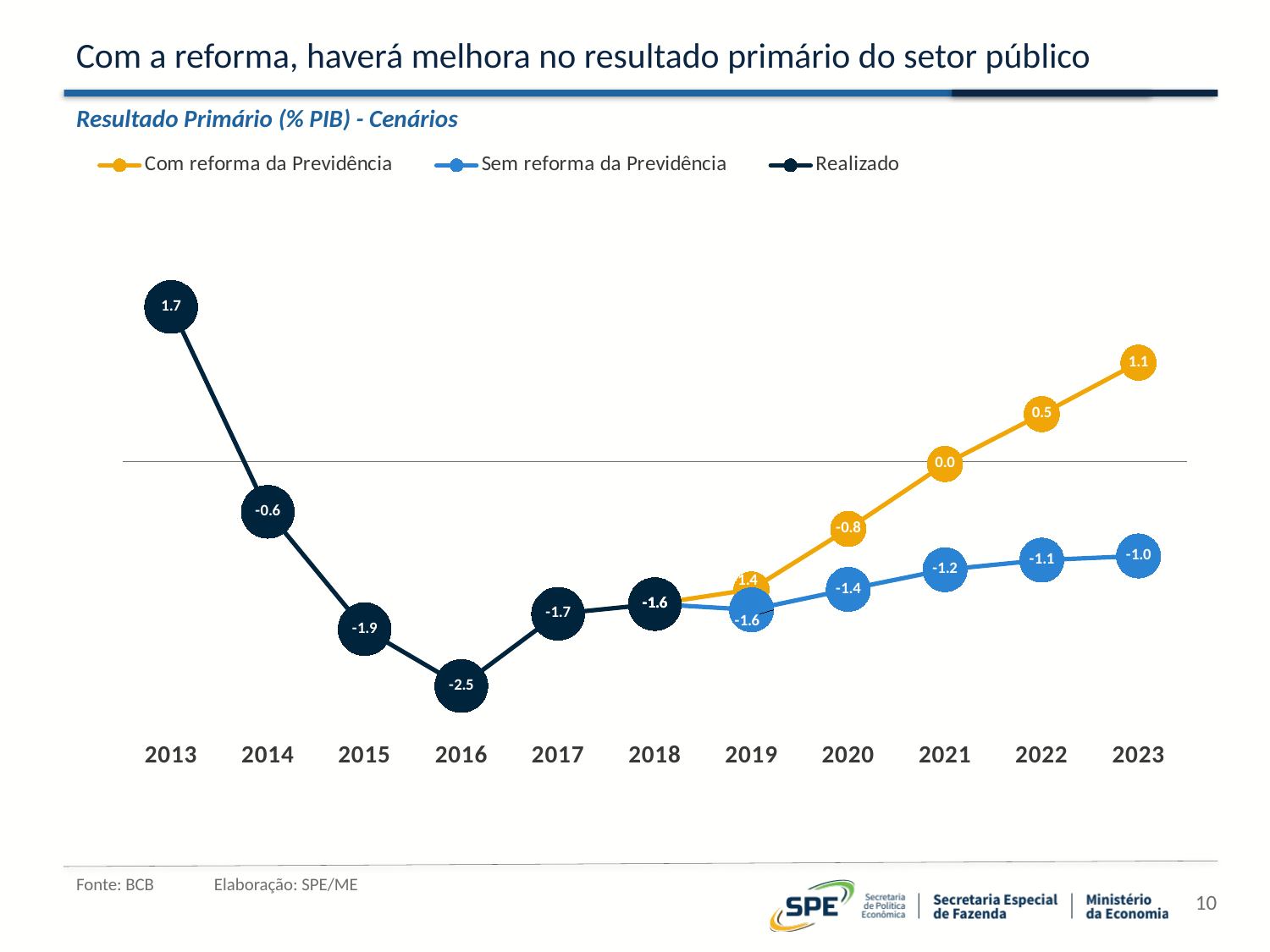
What kind of chart is shown on the slide? Line chart What is the value of the Com reforma da Previdência series in 2023? 1.1 In which year does the Realizado series reach its lowest value? 2016 In which year does the Com reforma da Previdência series reach its highest value? 2023 How many years are shown on the x axis? 11 In 2020, which series has the higher value: Com reforma da Previdência or Sem reforma da Previdência? Com reforma da Previdência Does the Com reforma da Previdência series rise or fall from 2019 to 2023? Rise What is the value of the Sem reforma da Previdência series in 2021? -1.2 How many series does the legend list? 3 What is the value of the Realizado series in 2013? 1.7 What is the value of the Realizado series in 2016? -2.5 What is the difference between the Com reforma da Previdência and Sem reforma da Previdência values in 2023? 2.1